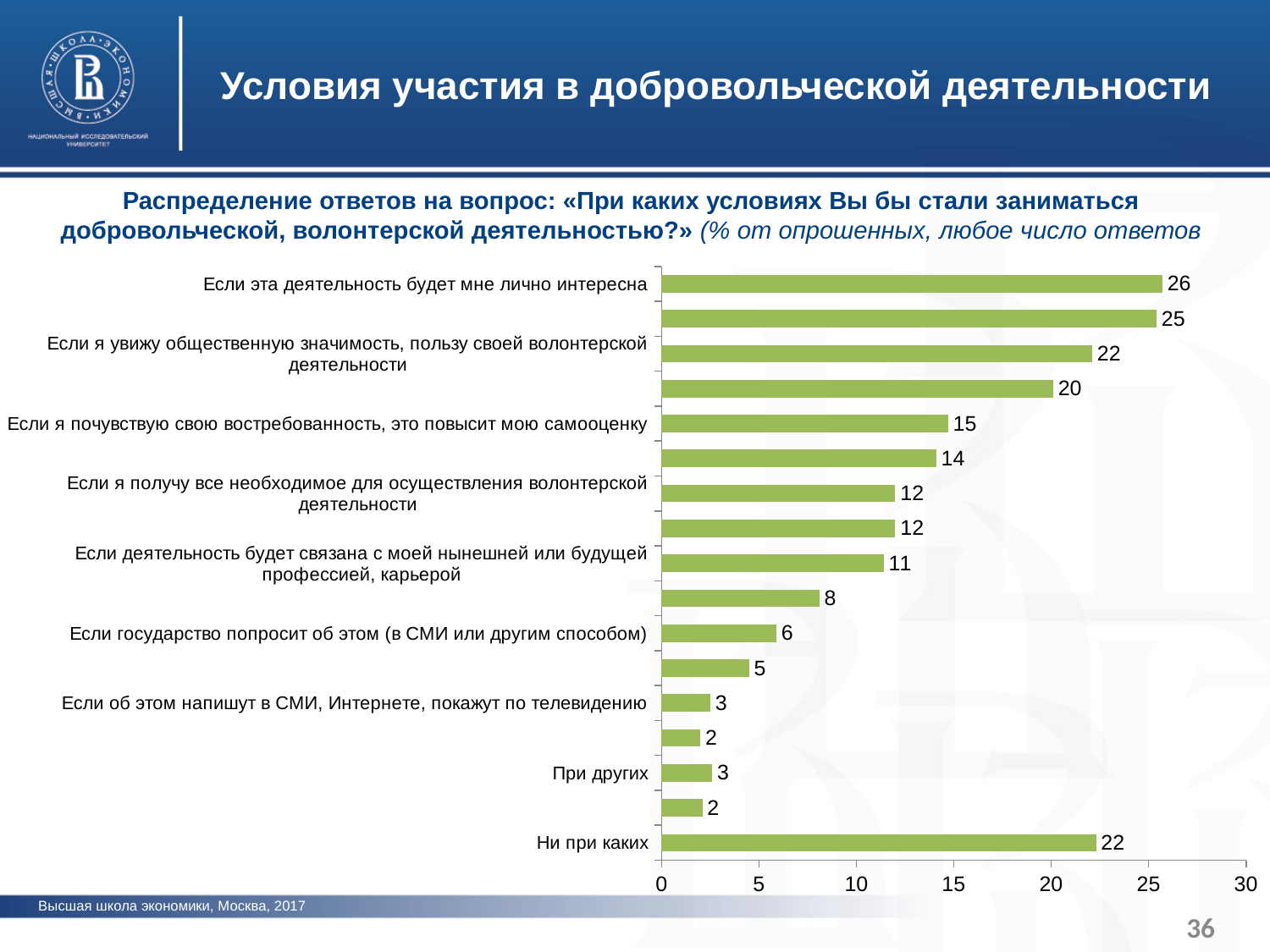
Is the value for «Если об этом напишут в СМИ, Интернете, покажут по телевидению» greater or less than 5? less What is the value for «Если деятельность будет связана с моей нынешней или будущей профессией, карьерой»? 11 What is the value for «Если государство попросит об этом (в СМИ или другим способом)»? 6 What is the value for «При других»? 3 What is the value for «Ни при каких»? 22 Which is larger: the value for «Ни при каких» or the value for «Если я почувствую свою востребованность, это повысит мою самооценку»? Ни при каких What type of chart is shown on the slide? bar chart What is the value for «Если эта деятельность будет мне лично интересна»? 26 What is the maximum value shown on the horizontal axis of the chart? 30 What is the difference between the value for «Если эта деятельность будет мне лично интересна» and the value for «Ни при каких»? 4 What is the value for «Если я почувствую свою востребованность, это повысит мою самооценку»? 15 Which condition has the highest value in the chart? Если эта деятельность будет мне лично интересна